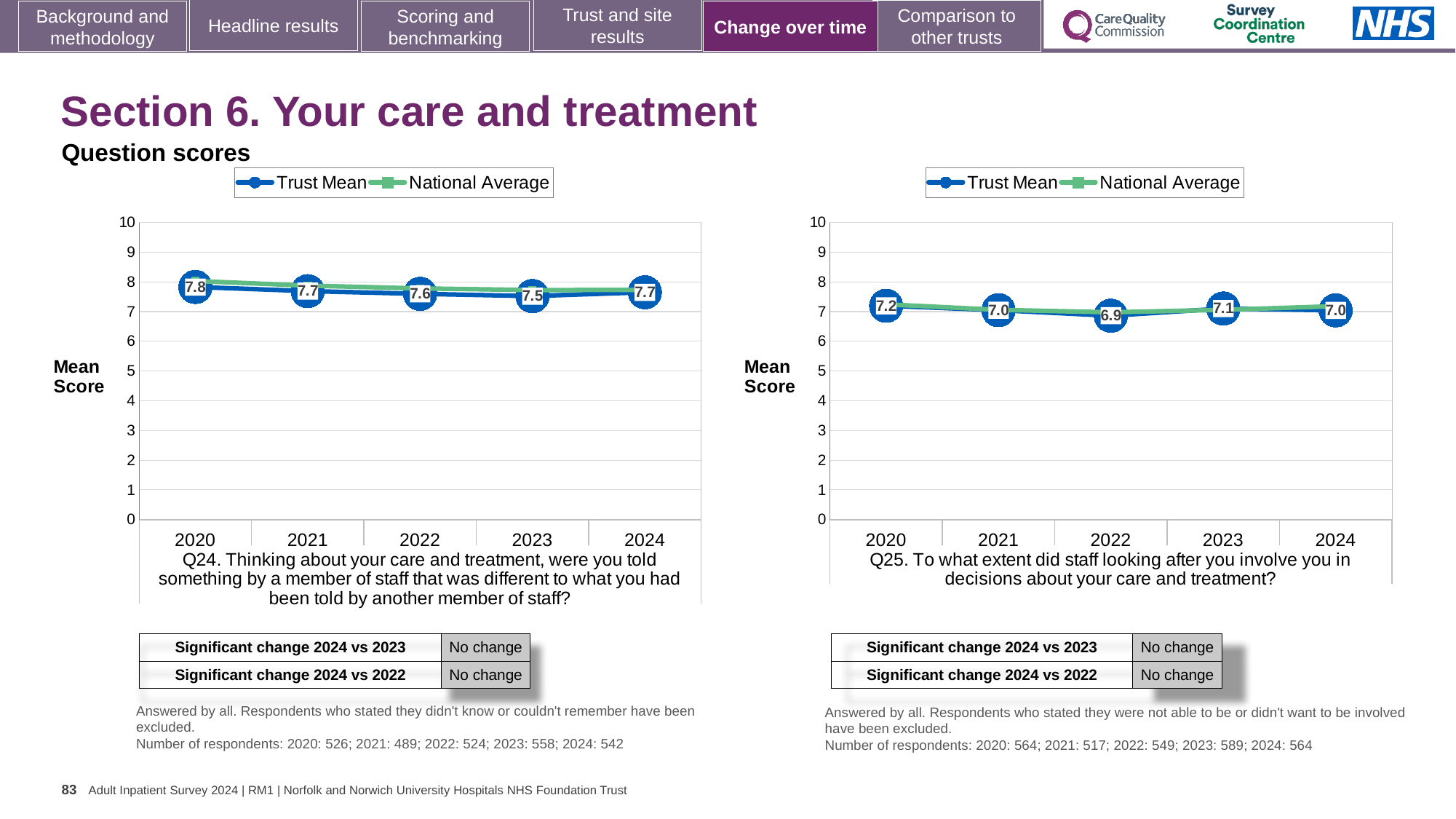
In the Q25 chart (right), how many series does the legend list? 2 In the Q24 chart (left), what is the Trust Mean score for 2023? 7.5 In the Q25 chart (right), which year has the highest Trust Mean score? 2020 In the Q25 chart (right), which series is shown in green in the legend? National Average In the Q25 chart (right), is the Trust Mean score for 2020 greater or less than 5? greater In the Q24 chart (left), how many years are plotted on the x axis? 5 In the Q24 chart (left), what is the difference between the Trust Mean scores for 2020 and 2023? 0.3 In the Q24 chart (left), which year has the lowest Trust Mean score? 2023 What type of chart is used for the Q24 chart (left)? Line chart In the Q24 chart (left), what is the Trust Mean score for 2020? 7.8 In the Q25 chart (right), what is the Trust Mean score for 2022? 6.9 In the Q25 chart (right), what is the Trust Mean score for 2024? 7.0